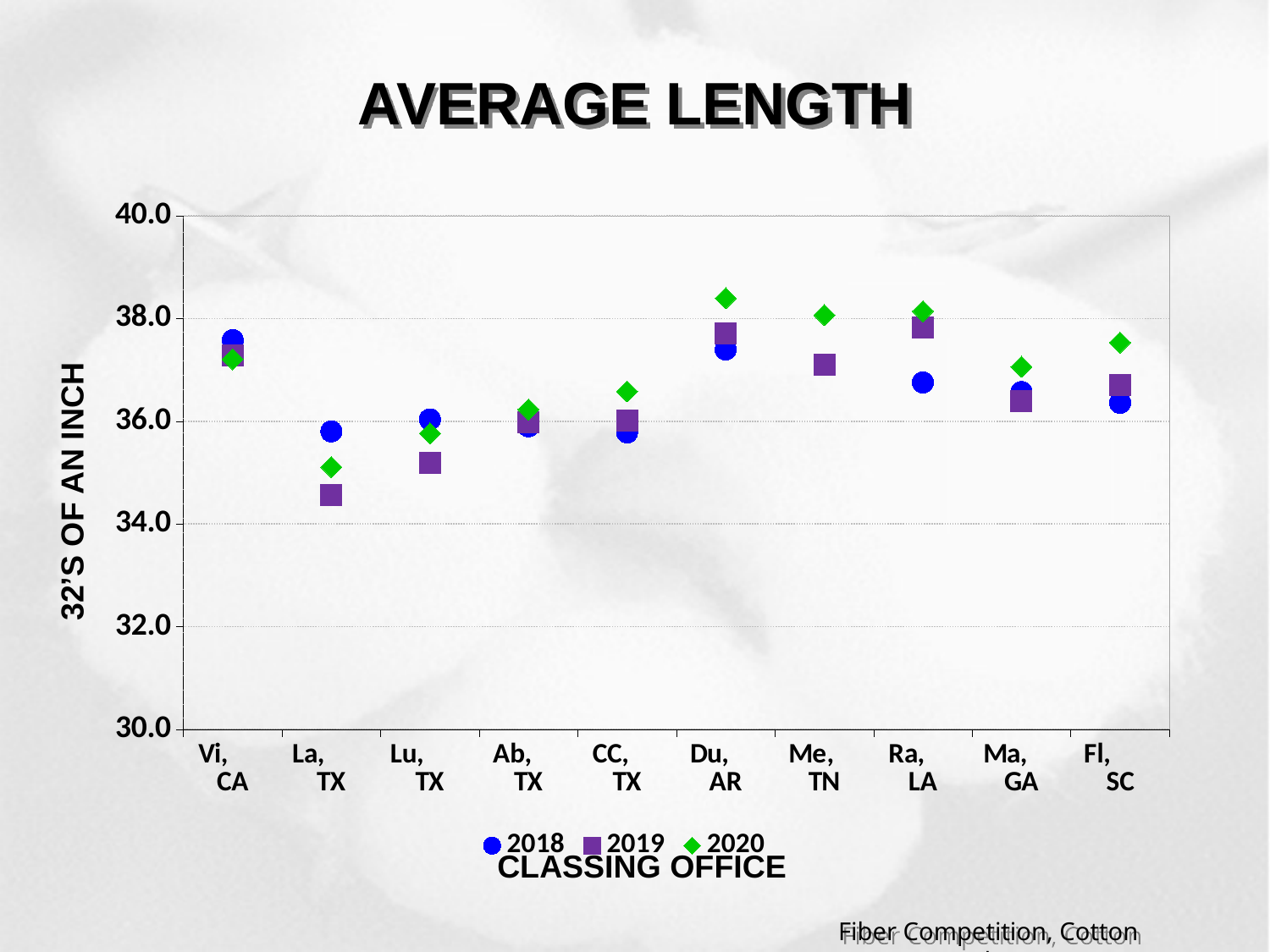
What is the title of the chart? AVERAGE LENGTH Is the 2018 value for Ra, LA greater or less than 38.0? less Is the 2019 value for La, TX greater or less than 36.0? less Is the 2020 value for Du, AR greater or less than 38.0? greater Which classing office has the lowest 2020 value? La, TX What is the label on the vertical axis of the chart? 32'S OF AN INCH What kind of chart is shown on the slide? scatter chart For Me, TN, which is larger: the 2019 value or the 2020 value? 2020 Which classing office has the lowest 2019 value? La, TX How many classing offices are shown along the x axis? 10 Which classing office has the highest 2020 value? Du, AR How many series does the legend list? 3